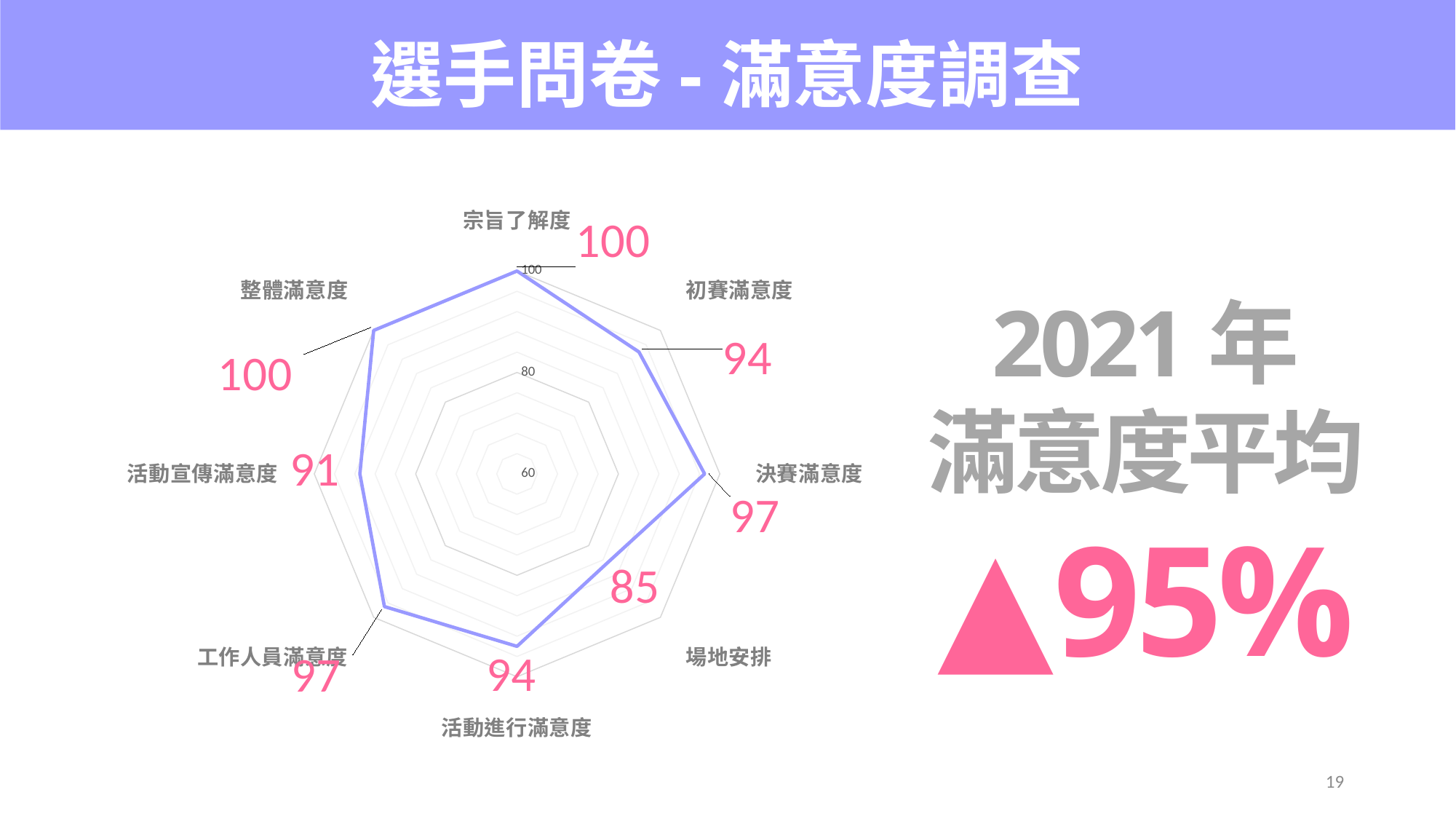
What is the value for 活動宣傳滿意度? 91 Which is larger, the value for 工作人員滿意度 or the value for 活動進行滿意度? 工作人員滿意度 How many categories does the radar chart have? 8 Which category has the lowest value? 場地安排 Is the value for 場地安排 greater or less than 80? greater What is the value for 宗旨了解度? 100 What is the difference between the values for 決賽滿意度 and 場地安排? 12 What kind of chart is shown on the slide? radar chart What is the value for 場地安排? 85 What is the difference between the values for 整體滿意度 and 活動宣傳滿意度? 9 What is the title of the slide containing the chart? 選手問卷 - 滿意度調查 What is the value for 初賽滿意度? 94